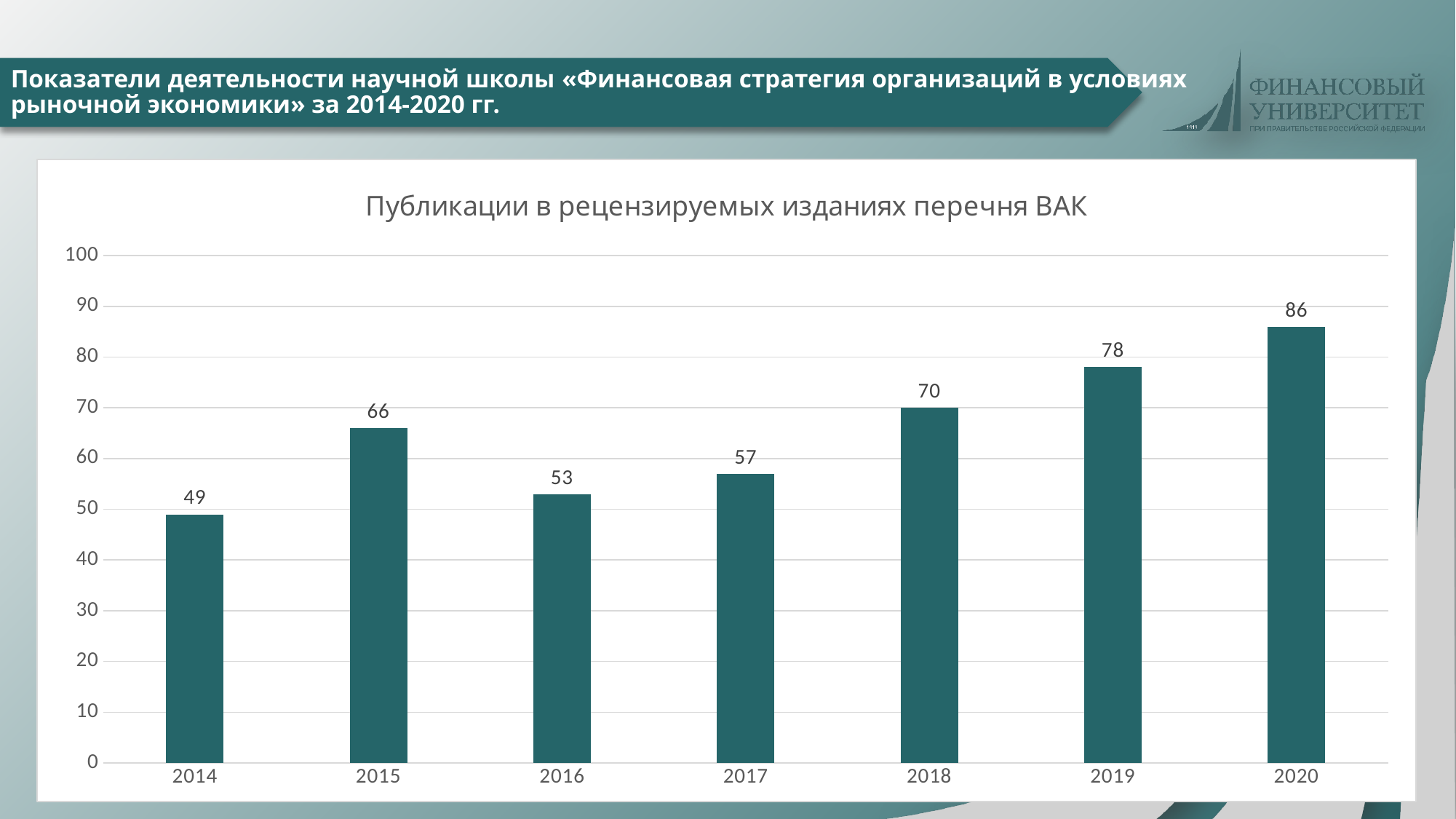
Is the value for 2018 greater or less than 60? greater What is the value for 2014? 49 What is the value for 2017? 57 Which year has the highest value? 2020 What is the title of the chart? Публикации в рецензируемых изданиях перечня ВАК What is the difference between the values for 2020 and 2014? 37 Which is larger, the value for 2015 or the value for 2017? 2015 What is the difference between the values for 2015 and 2016? 13 Which year has the lowest value? 2014 How many years are shown on the x axis? 7 What is the value for 2019? 78 What kind of chart is this? bar chart